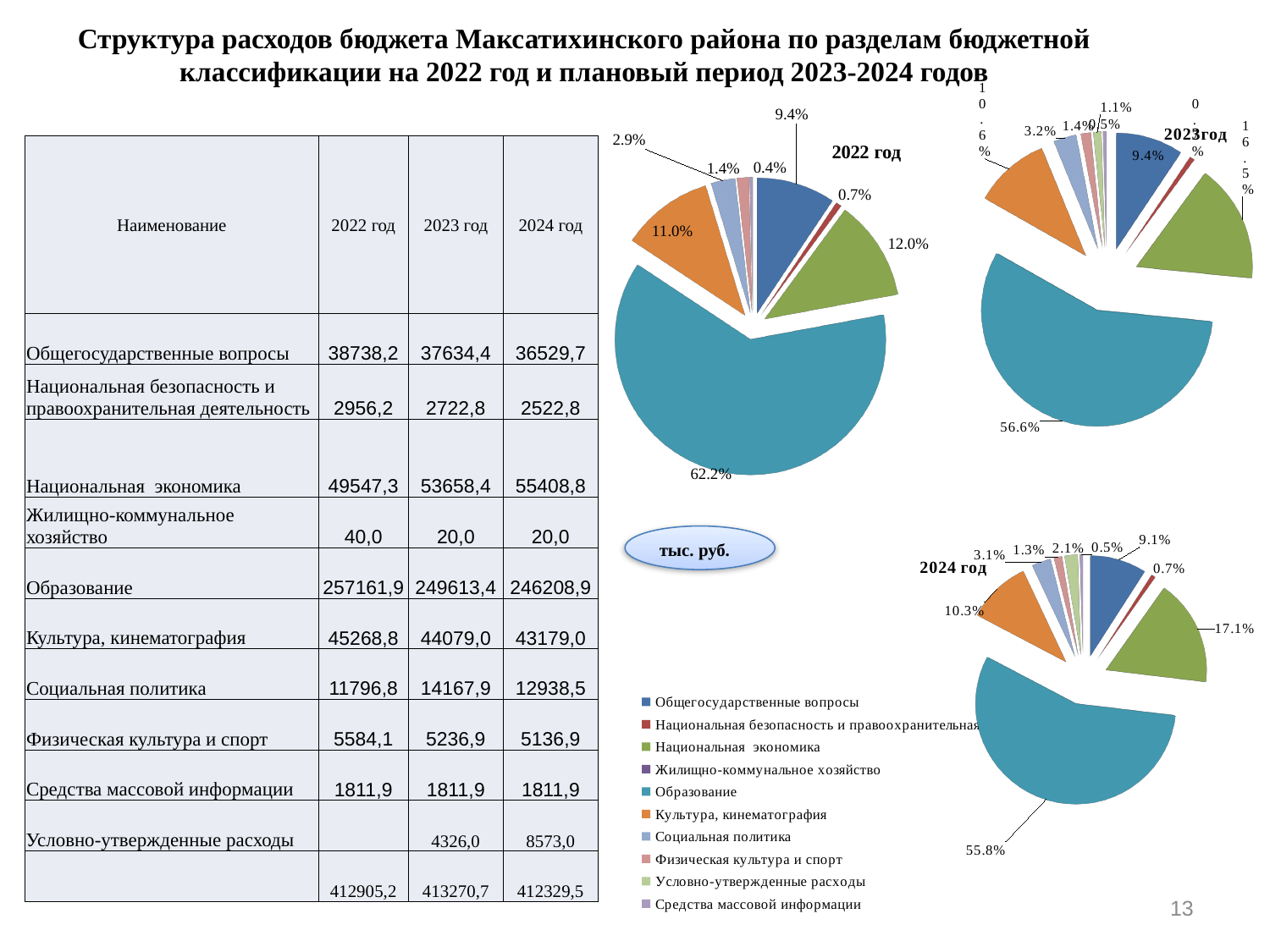
In the 2022 год pie chart, which category has the largest share? Образование How much larger is the Образование share in the 2022 год pie chart (62.2%) than in the 2024 год pie chart (55.8%)? 6.4% In the 2022 год pie chart, what share is labelled for the largest (teal) slice, Образование? 62.2% In the 2022 год pie chart, what share is labelled for Культура, кинематография (the orange slice)? 11.0% In the 2023 год pie chart, what share is labelled for Образование (the teal slice)? 56.6% How many categories does the shared legend of the pie charts list? 10 In the 2024 год pie chart, which is larger: the Образование slice or the Национальная экономика slice? Образование What kind of chart is used to show the 2022 год budget structure? pie chart Does the share of Образование rise or fall from the 2022 год chart to the 2024 год chart? fall